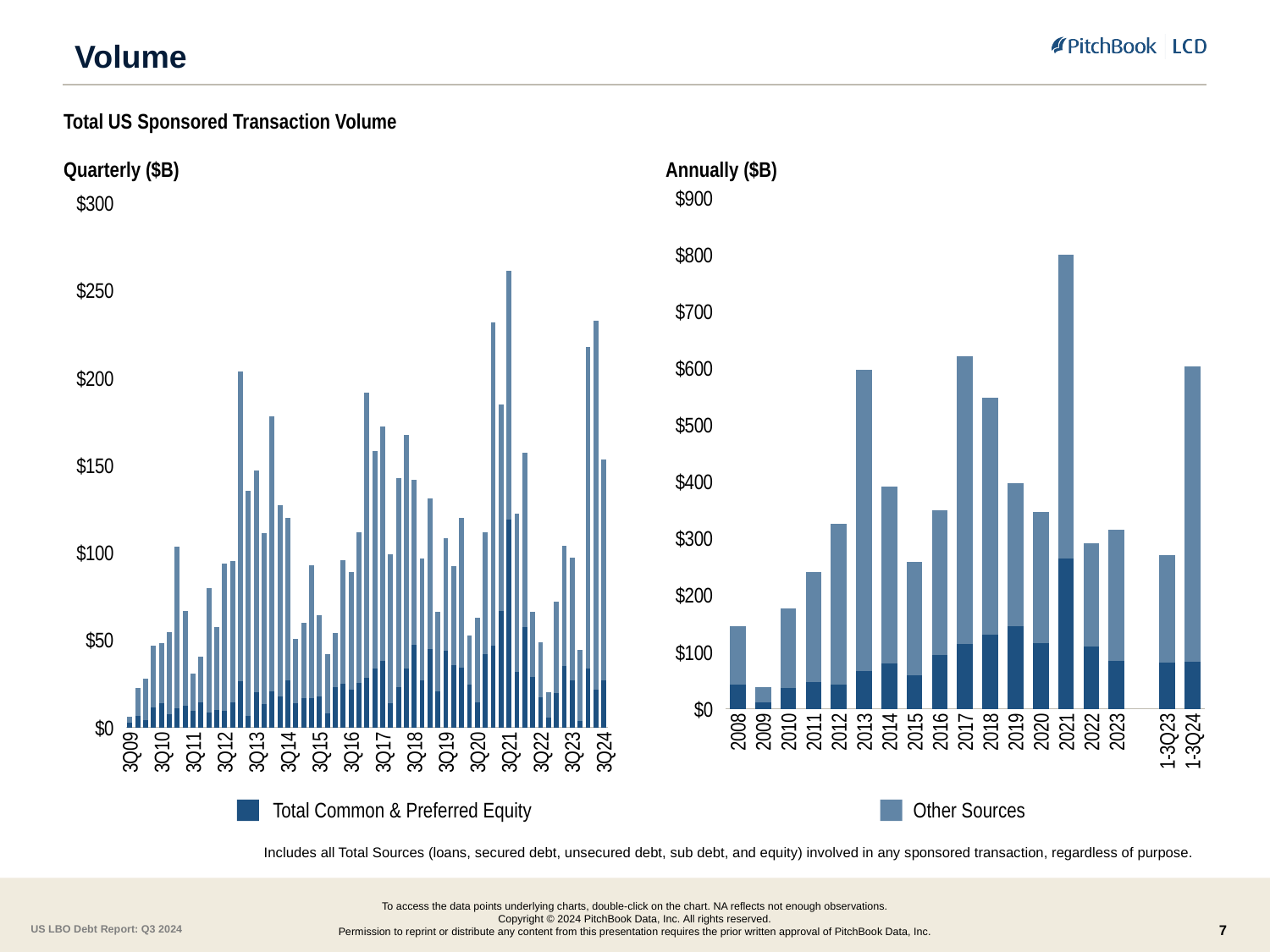
On the Annually ($B) chart, is the total value for 2018 greater or less than $500? greater On the Annually ($B) chart, which has the larger total: 1-3Q23 or 1-3Q24? 1-3Q24 On the Annually ($B) chart, which year has the highest total transaction volume? 2021 On the Annually ($B) chart, is the total value for 2021 greater or less than $700? greater How many series does the legend list for the charts? 2 On the Quarterly ($B) chart, is the total value for 3Q21 greater or less than $250? greater On the Quarterly ($B) chart, which labeled quarter has the tallest bar? 3Q21 On the Annually ($B) chart, how many bars are plotted? 18 On the Annually ($B) chart, which year has the lowest total transaction volume? 2009